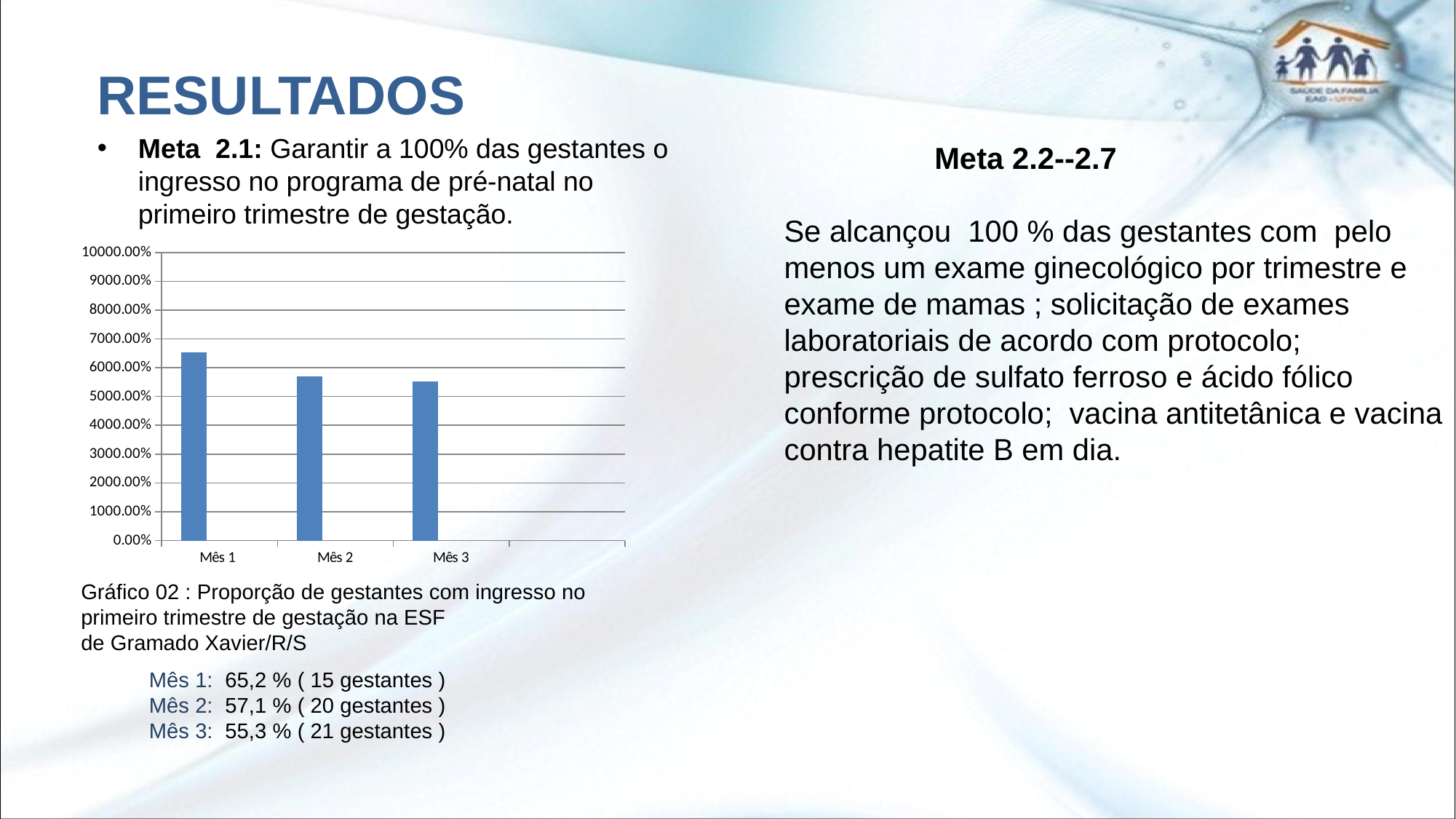
How many categories are plotted on the x axis of the chart? 3 What kind of chart is shown on the slide? bar chart Is the bar for Mês 1 greater or less than 7000.00%? less Which is larger in the chart, the bar for Mês 1 or the bar for Mês 3? Mês 1 What is the highest value shown on the chart's vertical axis? 10000.00% Is the bar for Mês 1 greater or less than 6000.00%? greater Is the bar for Mês 2 greater or less than 6000.00%? less What is the label of the first category on the x axis of the chart? Mês 1 Do the bars rise or fall from Mês 1 to Mês 3? fall Which month has the highest bar in the chart? Mês 1